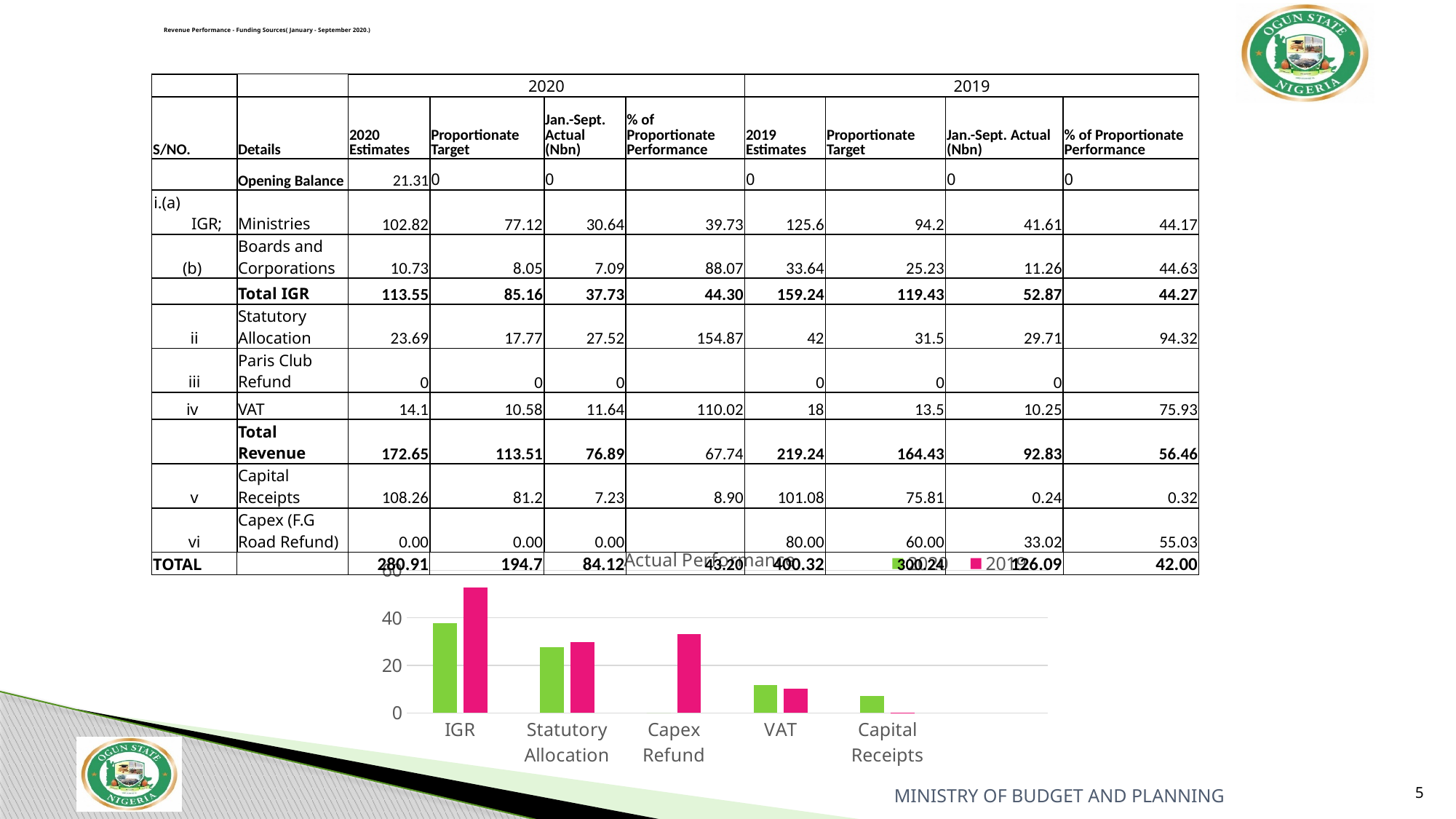
Is the 2019 value for IGR greater or less than 40? greater How many series does the chart's legend list? 2 Which category has the lowest 2019 value in the chart? Capital Receipts Which category has the highest 2019 bar in the chart? IGR How many categories are shown on the x axis of the chart? 5 For IGR, which series has the larger bar, 2020 or 2019? 2019 Is the 2019 value for Capex Refund greater or less than 20? greater Which category has the highest 2020 bar in the chart? IGR What is the title of the chart on the slide? Actual Performance What kind of chart is shown at the bottom of the slide? bar chart Is the 2020 value for VAT greater or less than 20? less Which category has the lowest 2020 value in the chart? Capex Refund